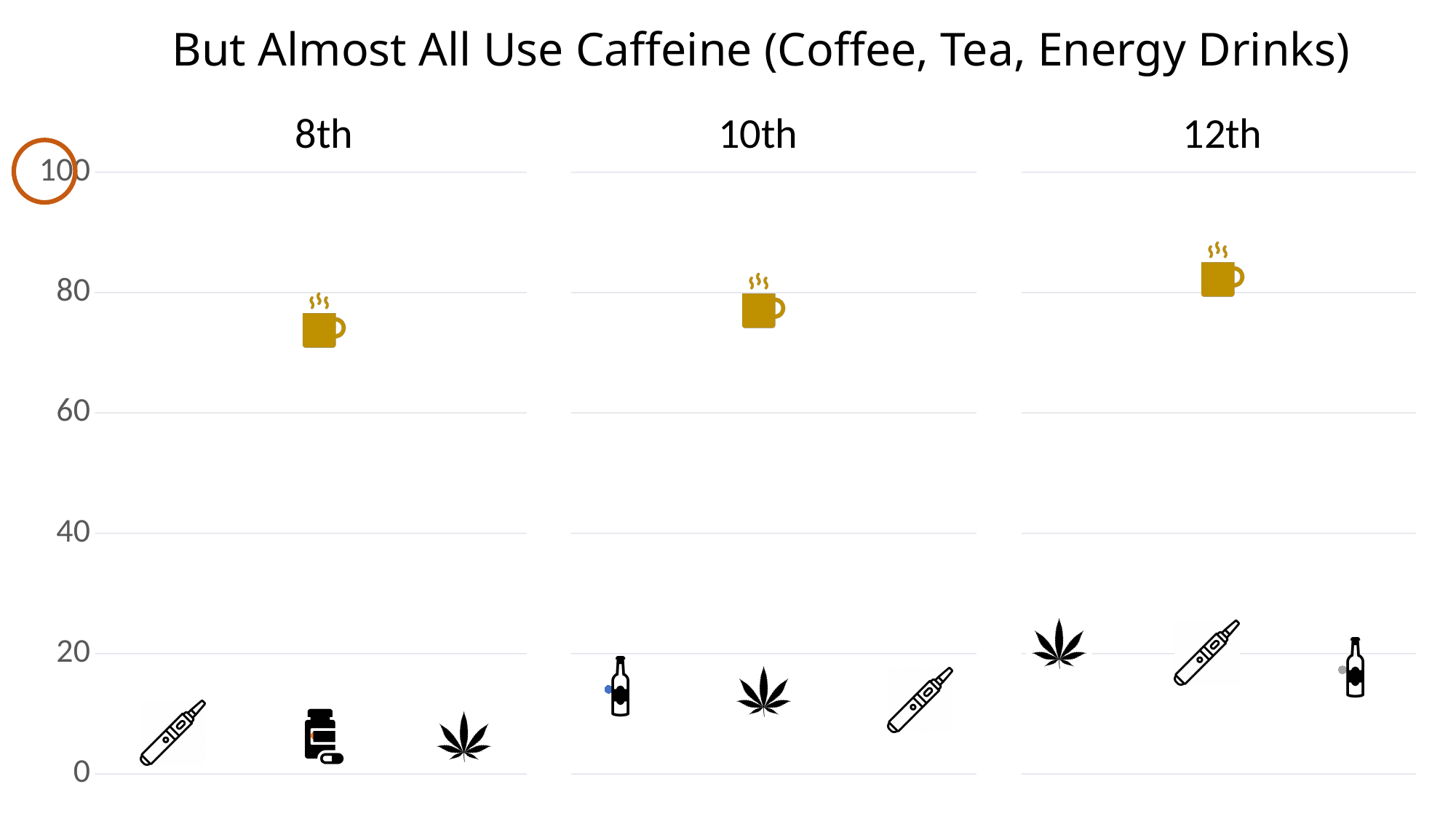
Is the caffeine value higher for 12th grade or for 8th grade? 12th grade What is the title of the chart? But Almost All Use Caffeine (Coffee, Tea, Energy Drinks) Which grade has the highest caffeine (coffee mug) value? 12th Is the caffeine (coffee mug) value for 10th grade greater or less than 100? less Which grade levels are shown as panel headings? 8th, 10th, 12th How many grade-level panels does the chart show? 3 Is the caffeine (coffee mug) value for 8th grade greater or less than 80? less Is the caffeine (coffee mug) value for 8th grade greater or less than 60? greater Which grade has the lowest caffeine (coffee mug) value? 8th What is the highest value shown on the vertical axis? 100 Does the caffeine (coffee mug) value rise or fall from 8th grade to 12th grade? rise